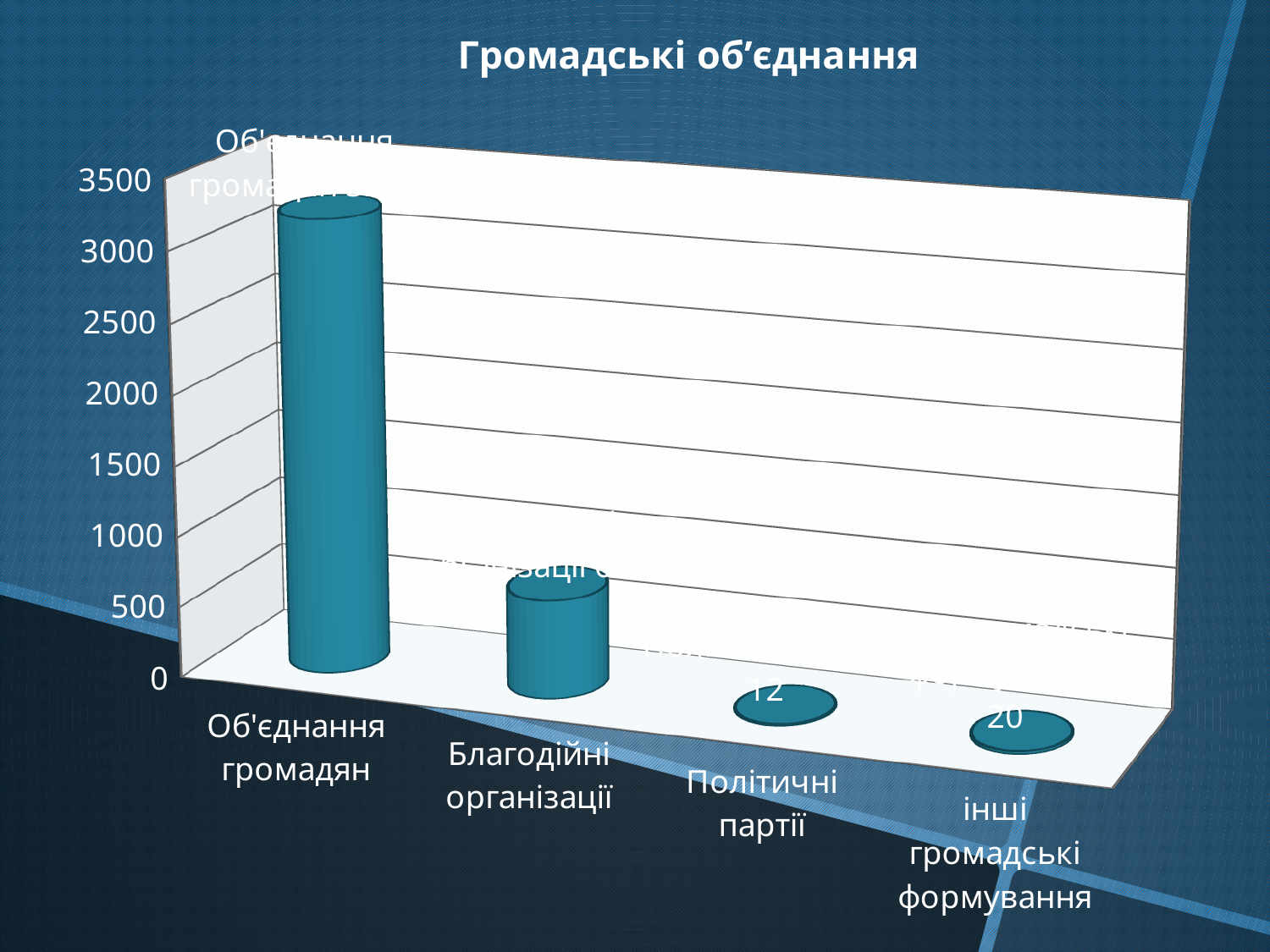
What is the difference between the values for інші громадські формування and Політичні партії? 8 What is the value for інші громадські формування? 20 Is the value for Об'єднання громадян greater or less than 2500? greater Which is larger, the value for Об'єднання громадян or the value for Благодійні організації? Об'єднання громадян Is the value for Благодійні організації greater or less than 1000? less Which category has the lowest value? Політичні партії What is the title of the chart? Громадські об’єднання Which category has the highest value? Об'єднання громадян Which is larger, the value for Політичні партії or the value for інші громадські формування? інші громадські формування What kind of chart is shown on the slide? Bar chart How many categories are shown on the chart? 4 What is the value for Політичні партії? 12